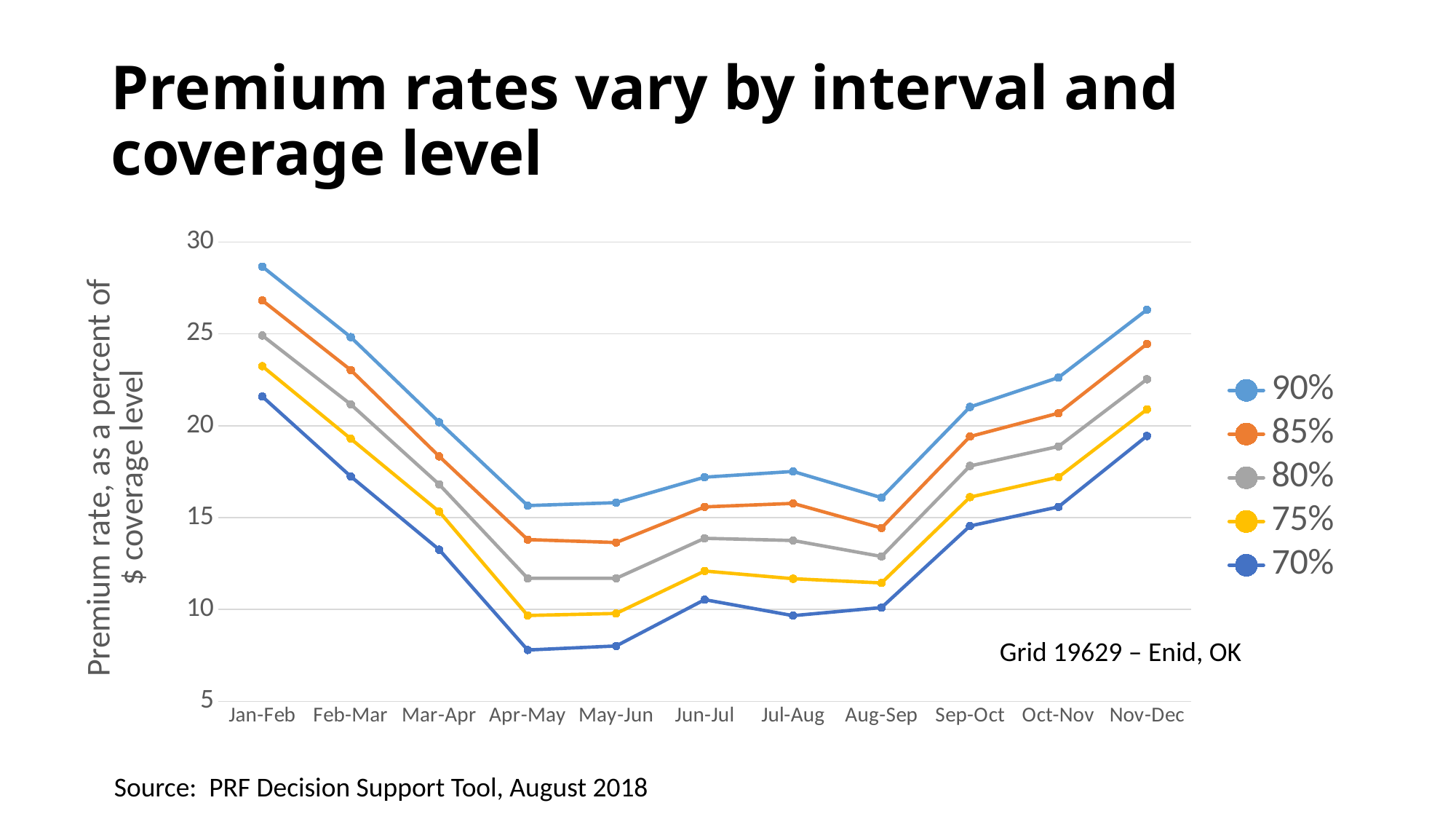
How many series does the legend list? 5 Is the 90% premium rate for Jan-Feb greater or less than 25? greater Is the 70% premium rate for Apr-May greater or less than 10? less How many intervals are shown along the x axis? 11 What is the y-axis title of the chart? Premium rate, as a percent of $ coverage level Do the premium rates rise or fall from Jan-Feb to Apr-May? fall Which coverage level series has the highest premium rates across all intervals? 90% For the 90% series, which is larger: the premium rate for Jan-Feb or for Nov-Dec? Jan-Feb For the 90% series, which interval has the highest premium rate? Jan-Feb Is the 80% premium rate for Jun-Jul greater or less than 15? less What kind of chart is shown on the slide? Line chart Which coverage level series has the lowest premium rates across all intervals? 70%